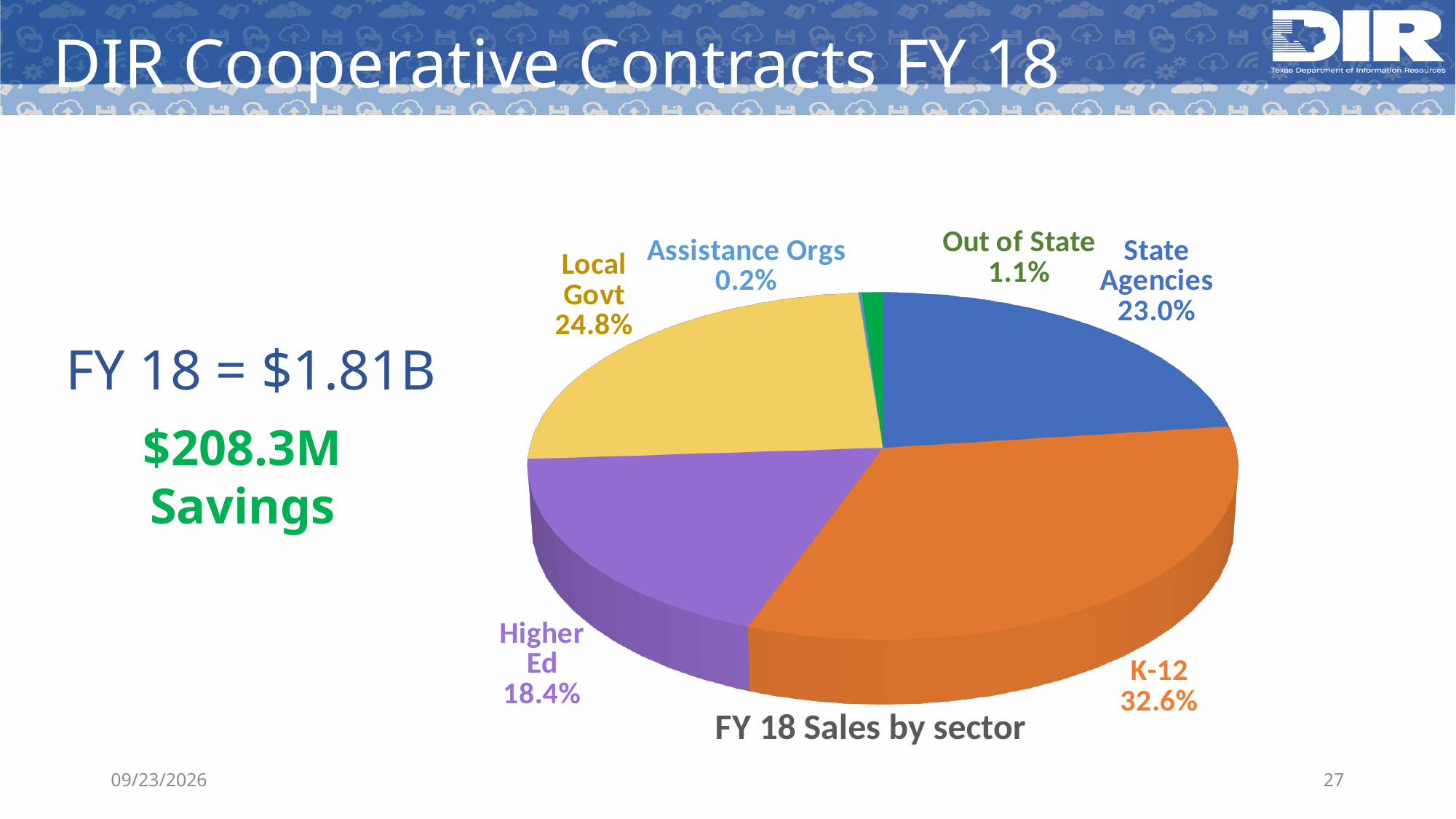
What is the title of the chart? FY 18 Sales by sector What is the value shown for State Agencies? 23.0% What is the value shown for Assistance Orgs? 0.2% What share of FY 18 sales does Local Govt account for? 24.8% What is the difference in percentage points between K-12 and State Agencies? 9.6 Which sector has the largest share of FY 18 sales? K-12 What is the value shown for Higher Ed? 18.4% What kind of chart is shown on the slide? pie chart What share of FY 18 sales does K-12 account for? 32.6% Which sector has the smallest share of FY 18 sales? Assistance Orgs How many sectors are shown in the pie chart? 6 Which is larger, the share for Local Govt or the share for Higher Ed? Local Govt